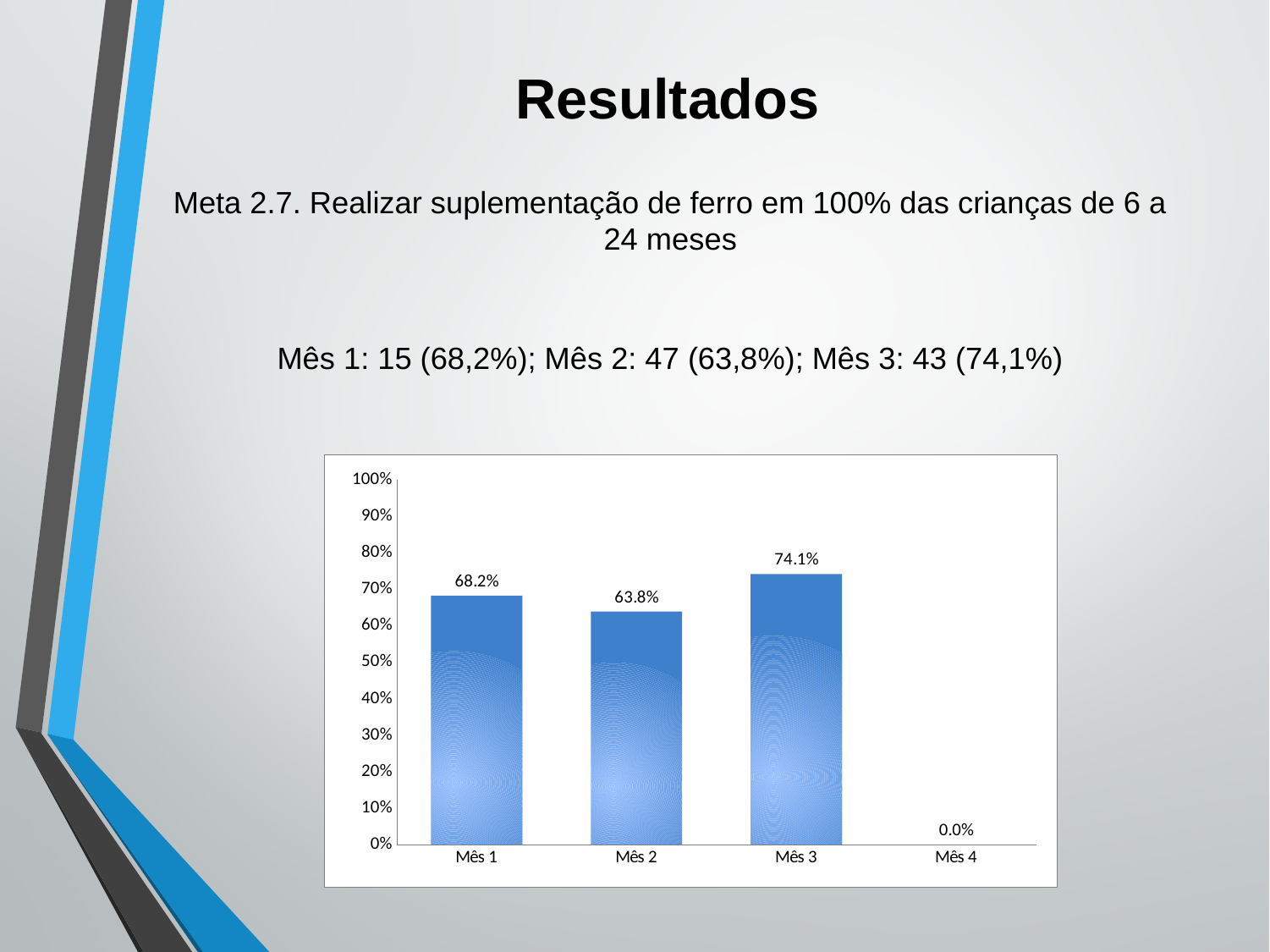
What kind of chart is shown on the slide? bar chart What is the value for Mês 4? 0.0% How many categories are shown on the x axis? 4 Is the value for Mês 3 greater or less than 70%? greater What is the value for Mês 1? 68.2% Which month has the highest value? Mês 3 Which is larger, the value for Mês 1 or the value for Mês 2? Mês 1 What is the value for Mês 3? 74.1% Which month has the lowest value? Mês 4 What is the difference between the values for Mês 3 and Mês 2? 10.3% What is the maximum value shown on the y axis? 100% What is the value for Mês 2? 63.8%